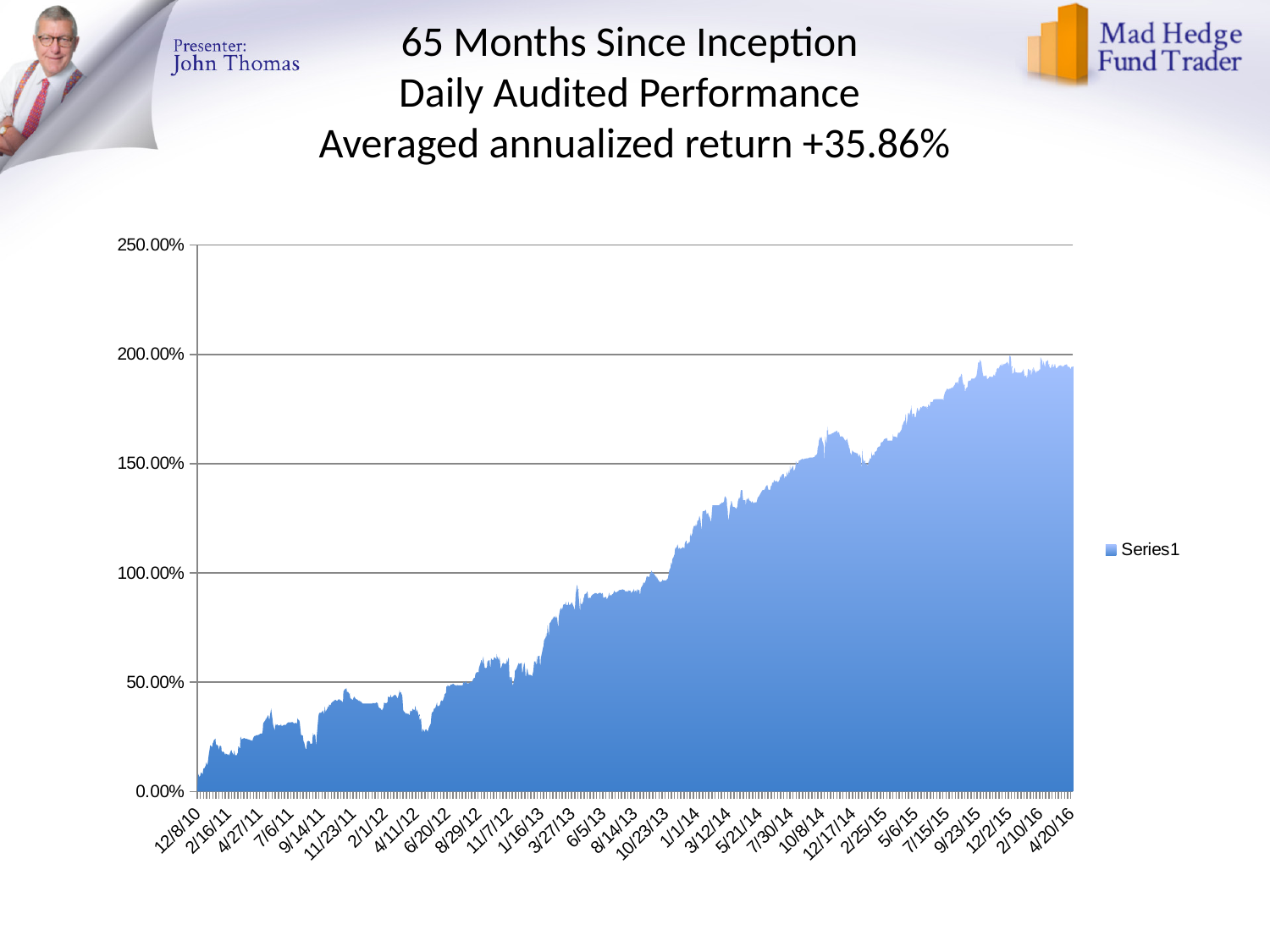
Is the value at 6/5/13 greater or less than 100.00%? less How many series does the legend list? 1 Is the value at 3/12/14 greater or less than 100.00%? greater Is the value at 12/8/10 greater or less than 50.00%? less What kind of chart is shown on the slide? area chart What is the name of the series shown in the legend? Series1 What averaged annualized return is stated in the chart title? +35.86% Overall, do the values rise or fall from 12/8/10 to 4/20/16? rise Which is larger, the value at 12/8/10 or the value at 4/20/16? 4/20/16